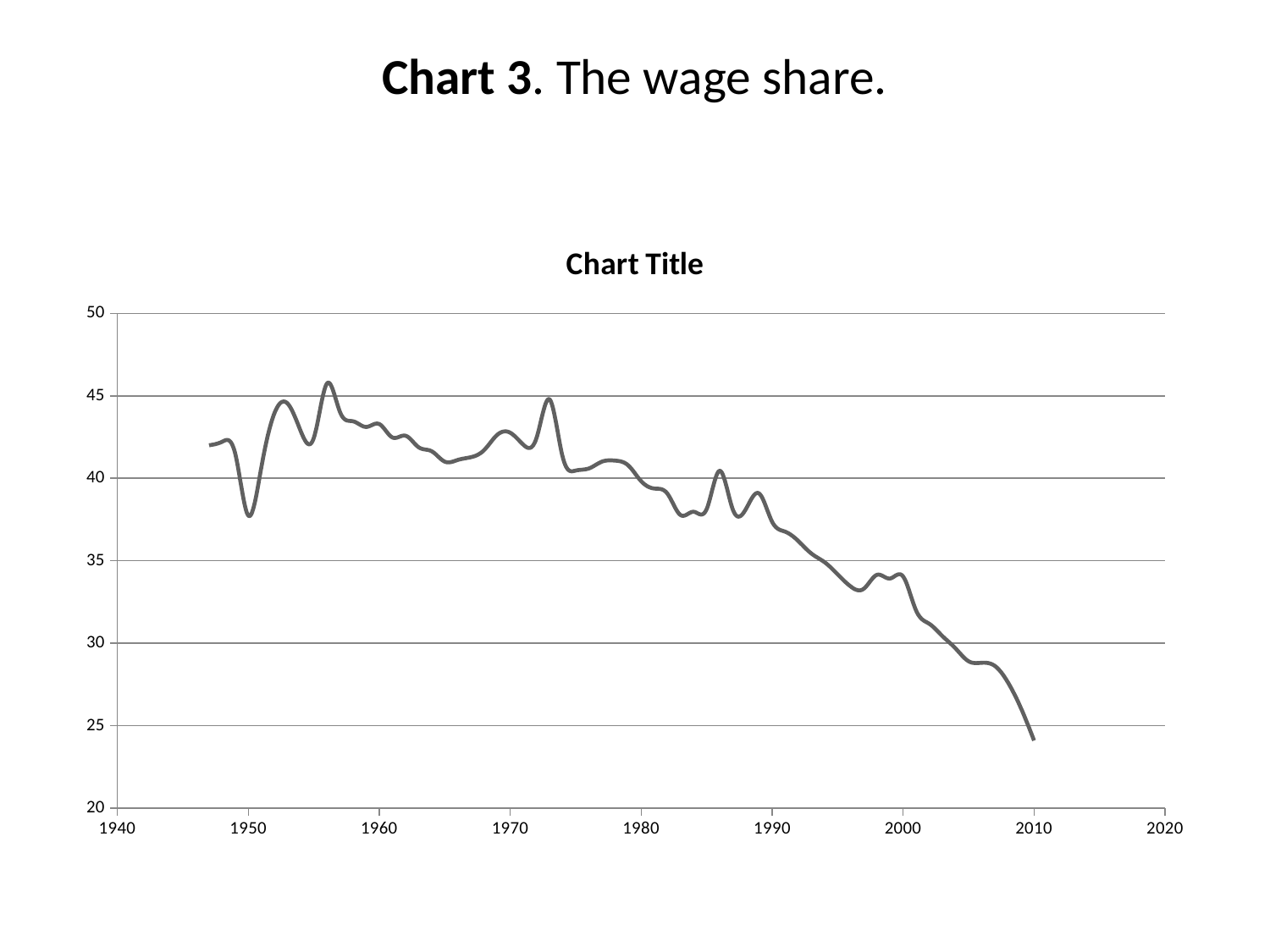
Is the value of the line at 2010 greater or less than 25? less Is the value of the line at 1960 larger or smaller than its value at 2000? larger In which year does the line reach its lowest value? 2010 What is the slide's title describing the chart? Chart 3. The wage share. Is the value of the line at 2005 greater or less than 30? less Is the value of the line at 1990 greater or less than 40? less What is the title printed above the plot area of the chart? Chart Title Overall, does the line rise or fall from 1950 to 2010? fall What kind of chart is shown on the slide? line chart